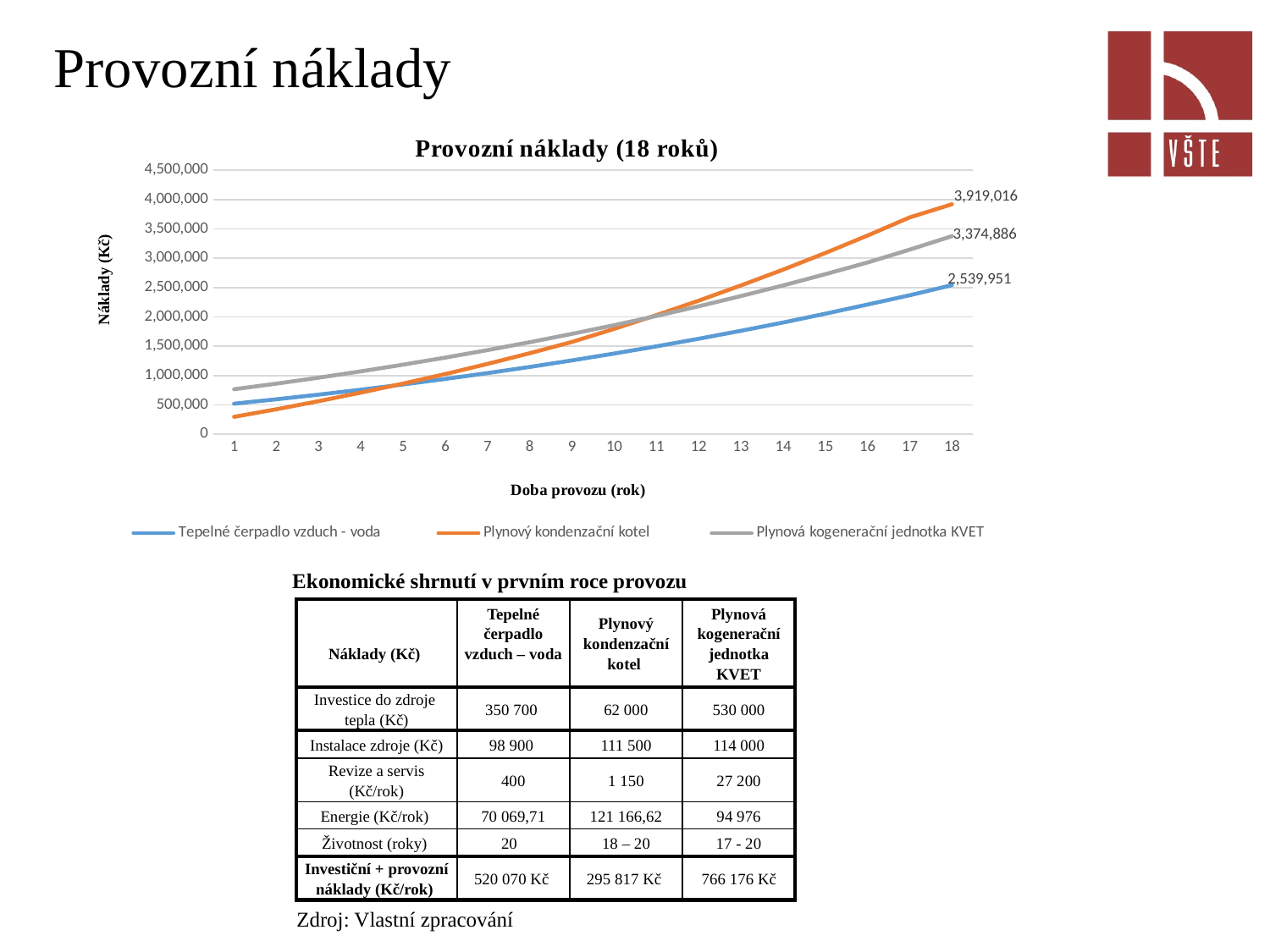
Do the values for Tepelné čerpadlo vzduch - voda rise or fall as the years increase? rise What is the value for Plynový kondenzační kotel at year 18? 3,919,016 Is the value for Plynová kogenerační jednotka KVET at year 1 greater or less than 500,000? greater How many years are plotted along the x axis of the chart? 18 Which series has the lowest value at year 18? Tepelné čerpadlo vzduch - voda What is the value for Plynová kogenerační jednotka KVET at year 18? 3,374,886 What is the value for Tepelné čerpadlo vzduch - voda at year 18? 2,539,951 Which series has the highest value at year 18? Plynový kondenzační kotel How many series does the chart legend list? 3 What type of chart is shown on the slide? line chart What is the difference between the year-18 values of Plynový kondenzační kotel and Tepelné čerpadlo vzduch - voda? 1,379,065 What is the title of the chart? Provozní náklady (18 roků)